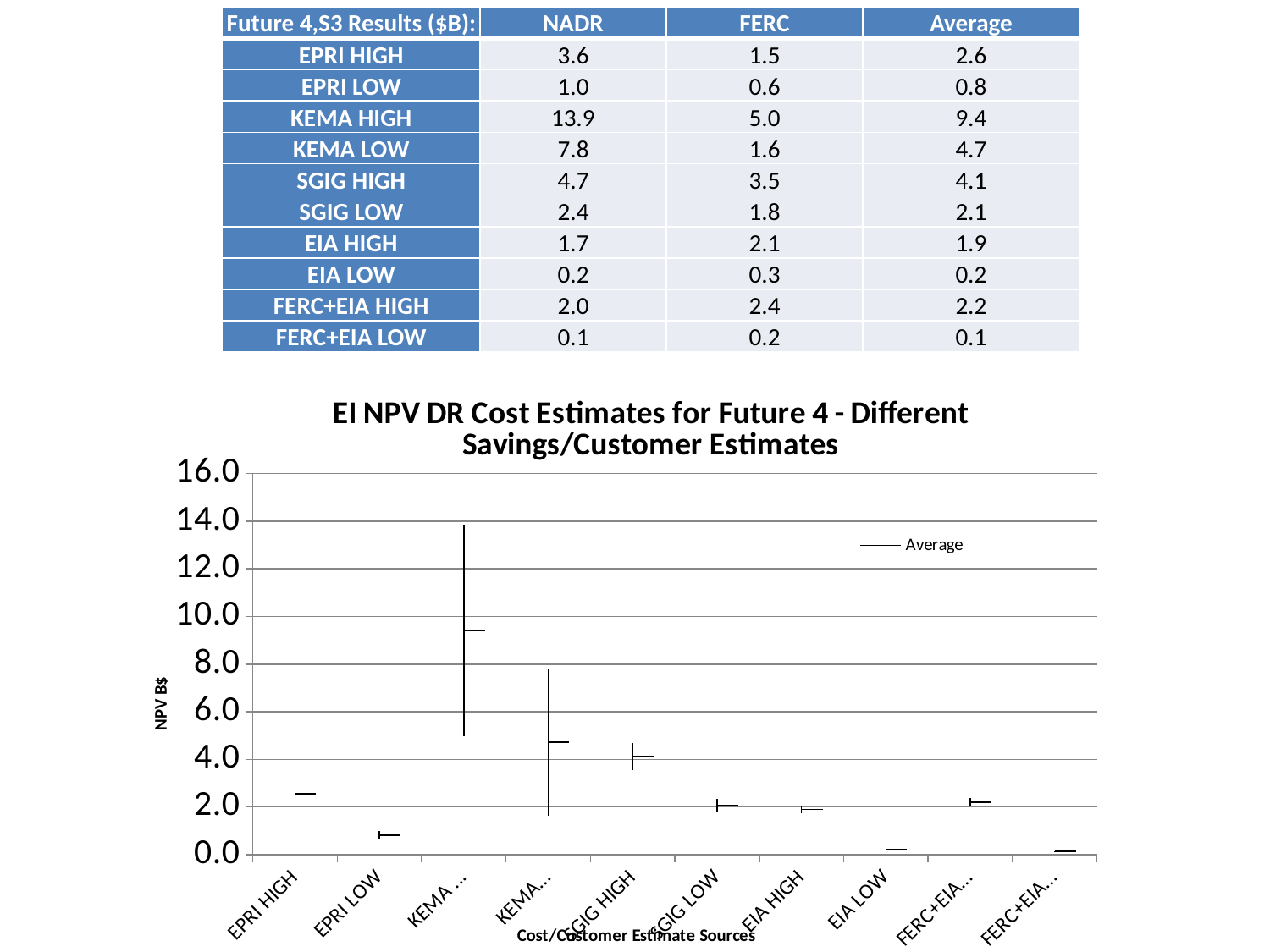
How many categories are shown on the x axis of the chart? 10 What is the label of the chart's y axis? NPV B$ What is the title of the chart? EI NPV DR Cost Estimates for Future 4 - Different Savings/Customer Estimates Which category has the highest Average value in the chart? KEMA HIGH According to the slide, what is the Average value for KEMA HIGH? 9.4 How many series does the chart legend list? 1 Which category has the lowest Average value according to the slide? FERC+EIA LOW Is the Average value for KEMA LOW greater or less than 6.0? less Which has a larger Average value, KEMA HIGH or SGIG HIGH? KEMA HIGH Is the Average value for EPRI LOW greater or less than 2.0? less What type of chart is shown on the slide? high-low line chart Is the Average value for KEMA HIGH greater or less than 8.0? greater